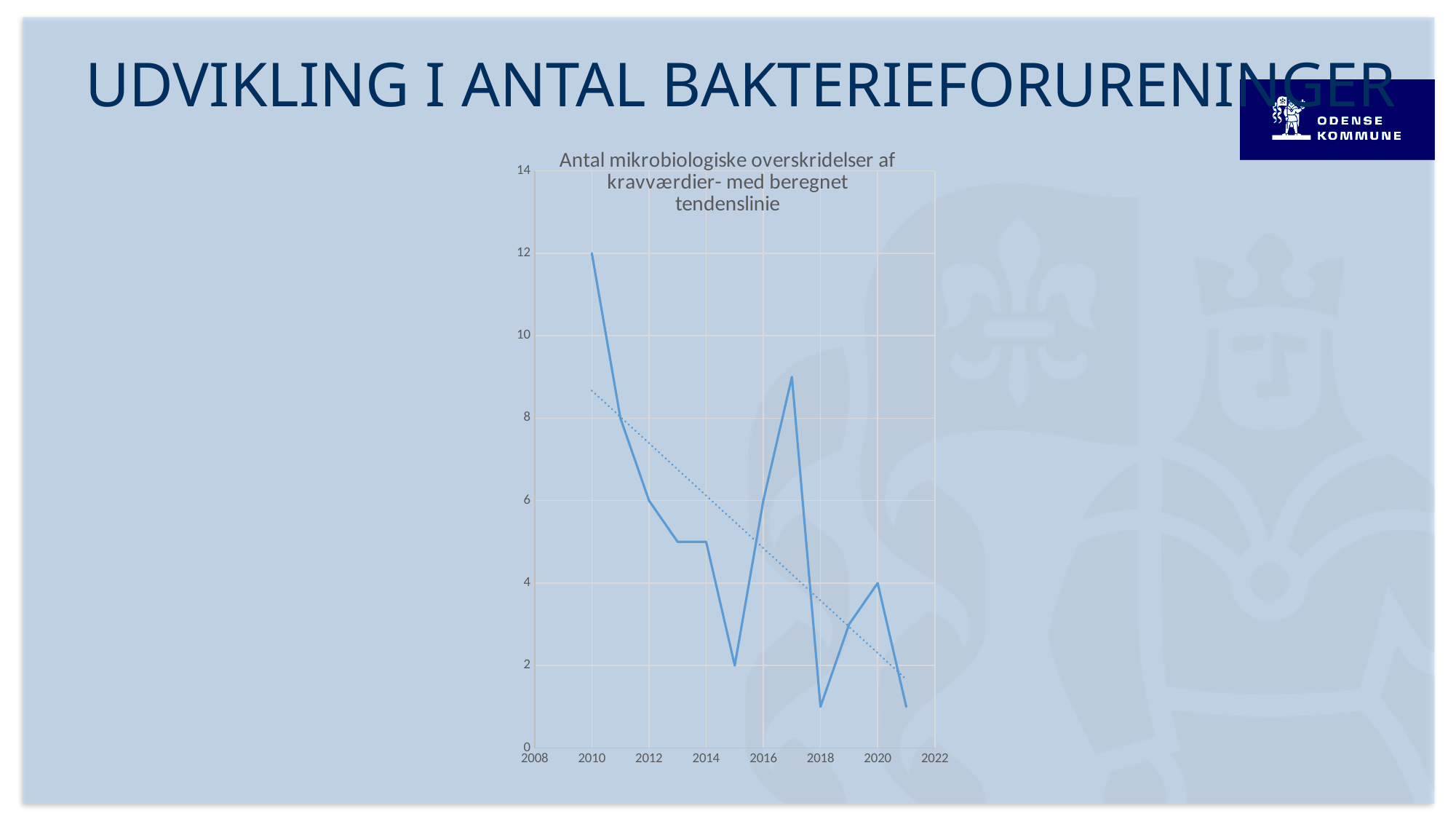
Does the dotted trend line rise or fall from left to right? Falls Is the value for 2018 greater or less than 2? less Which year has the highest value? 2010 What is the value for 2016? 6 Which is larger, the value for 2010 or the value for 2016? 2010 What is the title of the chart? Antal mikrobiologiske overskridelser af kravværdier- med beregnet tendenslinie What is the difference between the values for 2010 and 2020? 8 What is the value for 2010? 12 What is the value for 2020? 4 What type of chart is shown on the slide? Line chart What is the value for 2012? 6 Is the value for 2014 greater or less than 4? greater